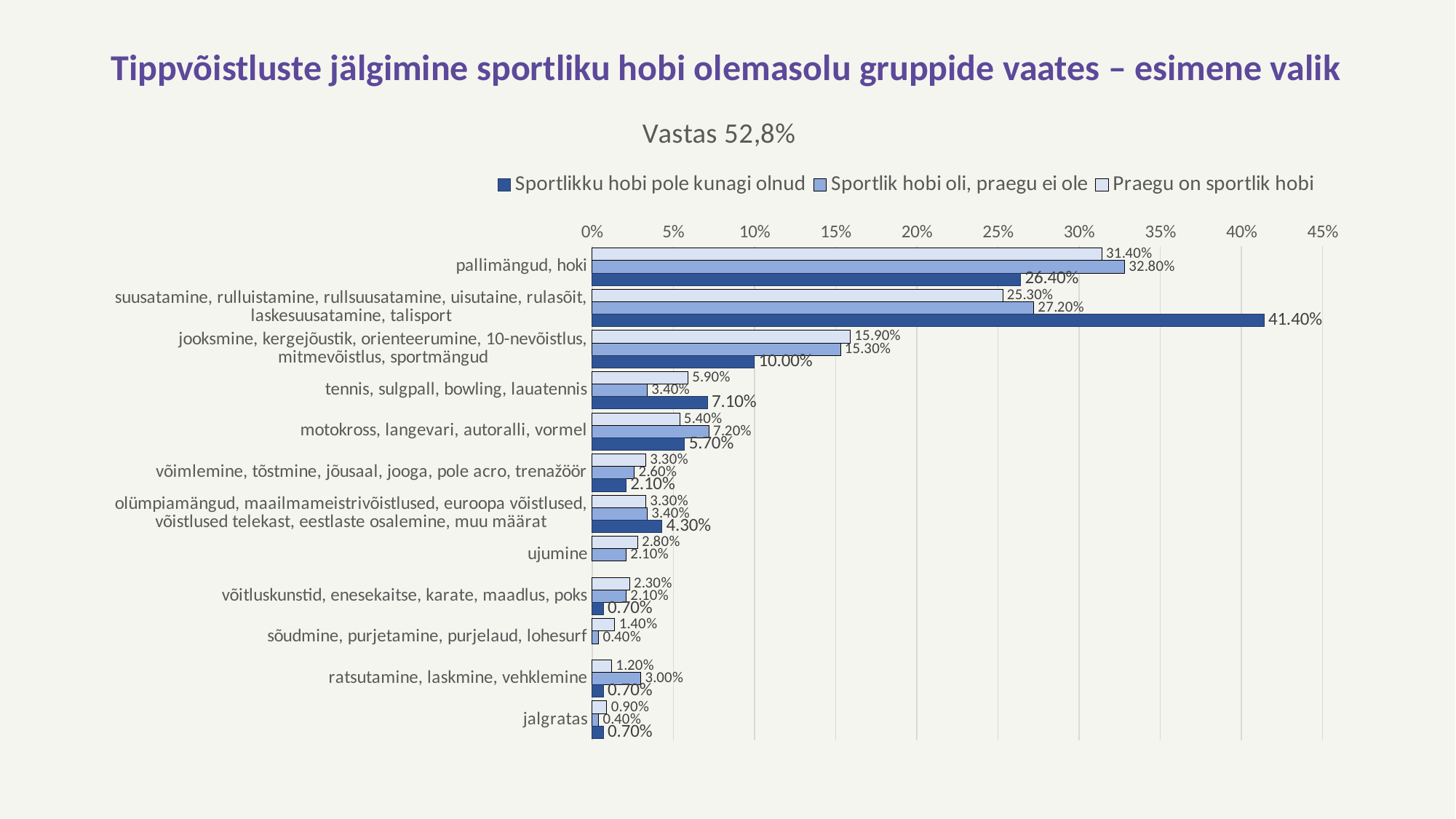
What kind of chart is shown on the slide? bar chart How many categories are shown on the chart? 12 How many series does the legend list? 3 What is the subtitle shown above the legend of the chart? Vastas 52,8% What is the value for 'Sportlik hobi oli, praegu ei ole' in the category 'pallimängud, hoki'? 32.80% What is the value for 'Praegu on sportlik hobi' in the category 'jooksmine, kergejõustik, orienteerumine, 10-nevõistlus, mitmevõistlus, sportmängud'? 15.90% For 'tennis, sulgpall, bowling, lauatennis', which is larger: the value for 'Sportlikku hobi pole kunagi olnud' or for 'Sportlik hobi oli, praegu ei ole'? Sportlikku hobi pole kunagi olnud What is the difference between the 'Sportlikku hobi pole kunagi olnud' value and the 'Praegu on sportlik hobi' value for 'pallimängud, hoki'? 5.00% Is the value for 'Sportlikku hobi pole kunagi olnud' in 'suusatamine, rulluistamine, rullsuusatamine, uisutaine, rulasõit, laskesuusatamine, talisport' greater or less than 40%? greater Which category has the highest value for 'Praegu on sportlik hobi'? pallimängud, hoki Which category has the highest value for 'Sportlikku hobi pole kunagi olnud'? suusatamine, rulluistamine, rullsuusatamine, uisutaine, rulasõit, laskesuusatamine, talisport What is the value for 'Sportlikku hobi pole kunagi olnud' in the category 'suusatamine, rulluistamine, rullsuusatamine, uisutaine, rulasõit, laskesuusatamine, talisport'? 41.40%